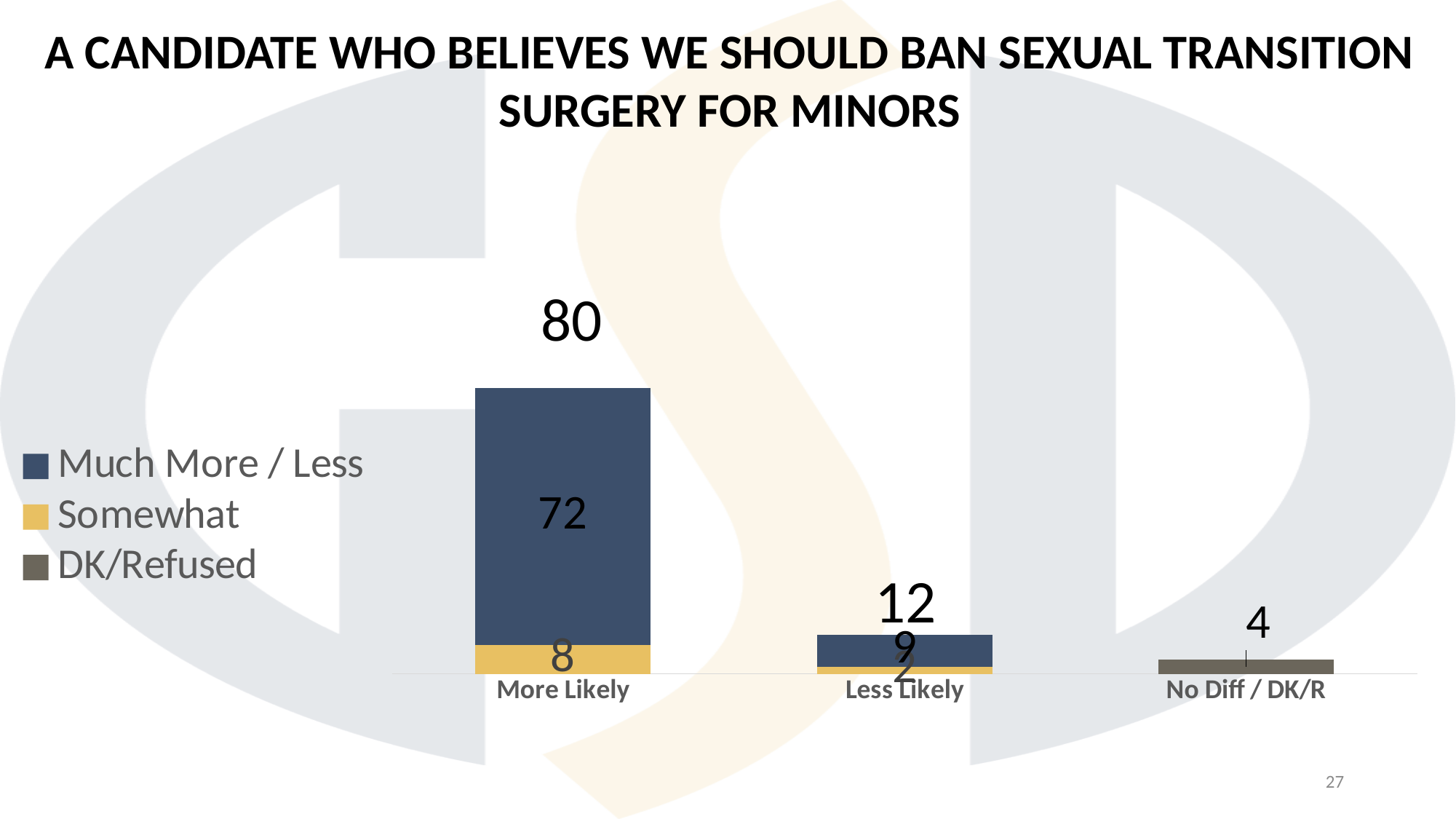
Which category has the highest total value? More Likely What is the total value shown above the More Likely bar? 80 What is the Much More / Less value for the More Likely category? 72 What is the Somewhat value for the More Likely category? 8 What is the total value shown above the Less Likely bar? 12 How many series does the legend list? 3 What is the Much More / Less value for the Less Likely category? 9 Which category has the lowest total value? No Diff / DK/R What type of chart is shown on the slide? Stacked bar chart What is the value for the No Diff / DK/R category? 4 What is the difference between the More Likely total and the Less Likely total? 68 How many categories are shown on the x axis? 3